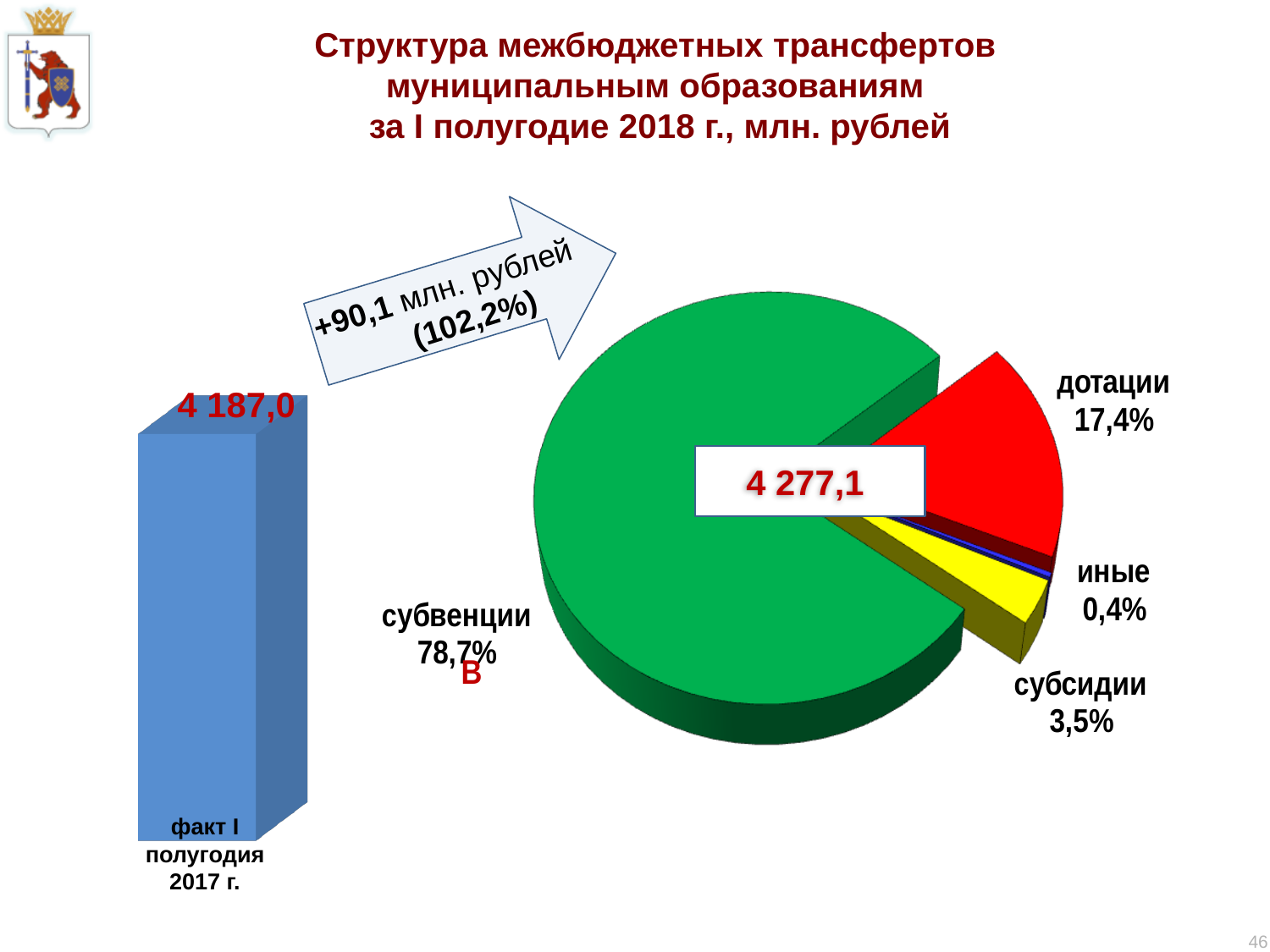
On the pie chart, which is larger: дотации or субсидии? дотации On the pie chart, what share do дотации have? 17,4% On the pie chart, which category has the largest share? субвенции On the pie chart, how many slices are there? 4 On the pie chart, what share do субсидии have? 3,5% On the pie chart, what is the difference in percentage points between дотации and субсидии? 13,9 What kind of chart is shown on the right side of the slide? pie chart On the pie chart, which category has the smallest share? иные On the pie chart, what share do субвенции have? 78,7% On the bar chart on the left, what is the value for факт I полугодия 2017 г.? 4 187,0 What value is printed in the centre of the pie chart? 4 277,1